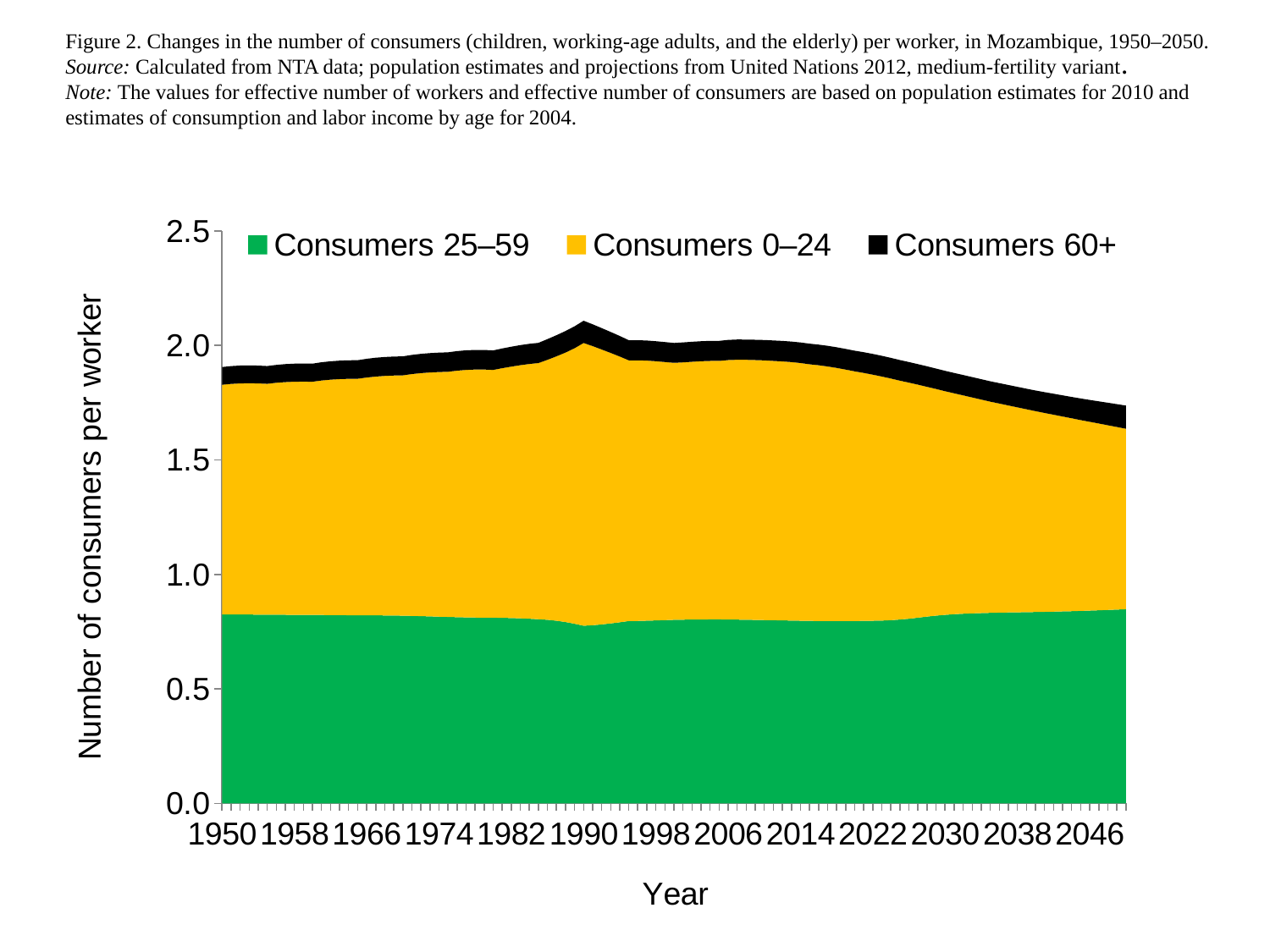
Is the total number of consumers per worker in 2046 greater or less than 2.0? less Does the total number of consumers per worker rise or fall between 2014 and 2046? fall What kind of chart is shown on the slide? stacked area chart Is the total number of consumers per worker in 1950 greater or less than 1.5? greater How many series does the legend list? 3 In 1950, which band is larger: Consumers 0–24 or Consumers 25–59? Consumers 0–24 Which series contributes the smallest share of consumers per worker throughout the period? Consumers 60+ What is the title of the vertical axis? Number of consumers per worker In which year does the total number of consumers per worker reach its highest point? 1990 Is the value for Consumers 25–59 in 1950 greater or less than 1.0? less Which series is shown in black in the chart? Consumers 60+